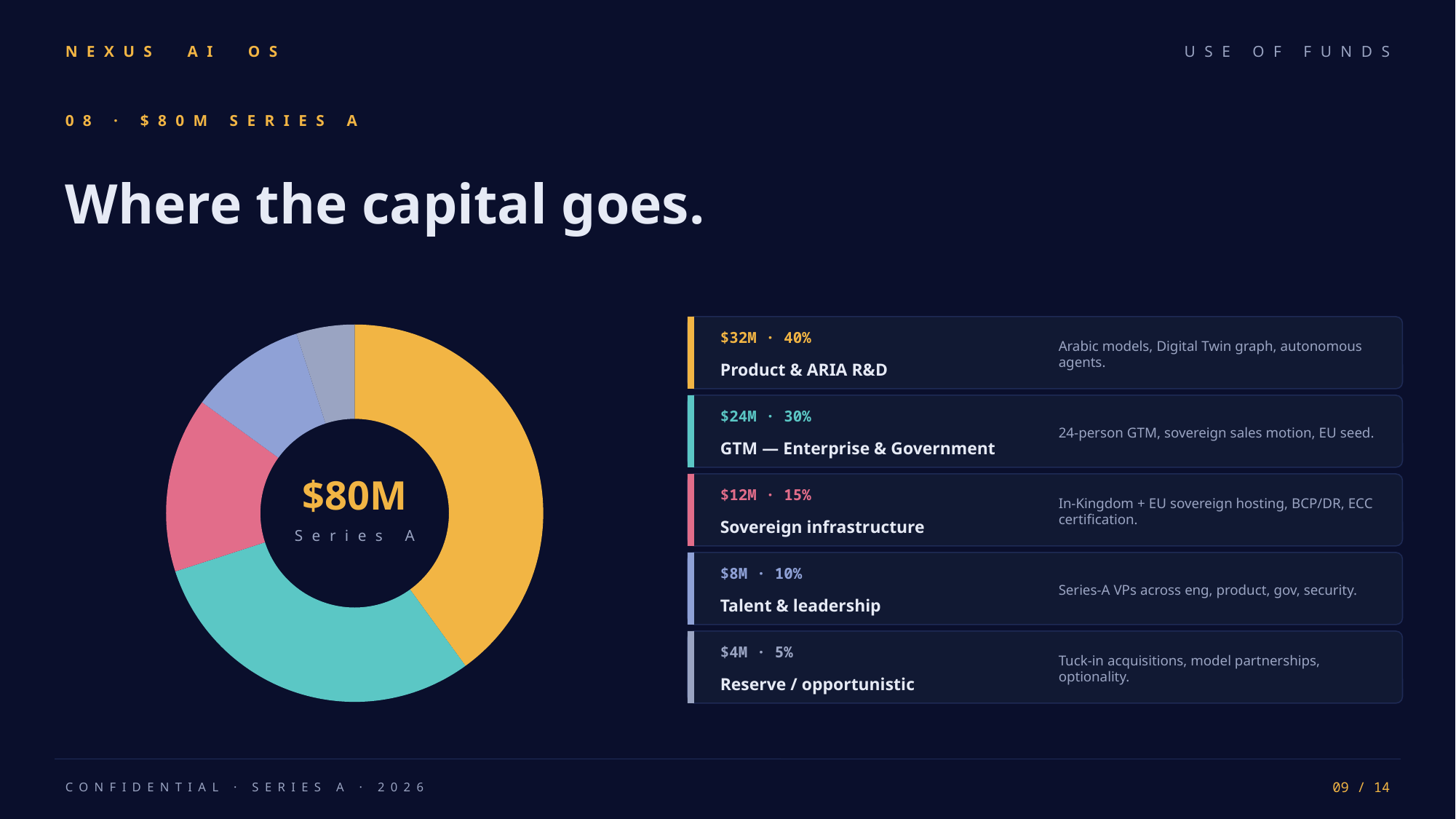
Which category receives the largest allocation? Product & ARIA R&D What total amount is shown in the centre of the donut chart? $80M What amount is allocated to Product & ARIA R&D? $32M What colour is the slice for GTM — Enterprise & Government? Teal What is the difference in dollars between the Product & ARIA R&D and GTM — Enterprise & Government allocations? $8M Which is larger, the allocation to Talent & leadership or to Sovereign infrastructure? Sovereign infrastructure What kind of chart is shown on the slide? Pie chart (donut) What share of the funds goes to Reserve / opportunistic? 5% What share of the funds goes to GTM — Enterprise & Government? 30% What amount is allocated to Sovereign infrastructure? $12M Which category receives the smallest allocation? Reserve / opportunistic How many categories does the chart break the $80M into? 5